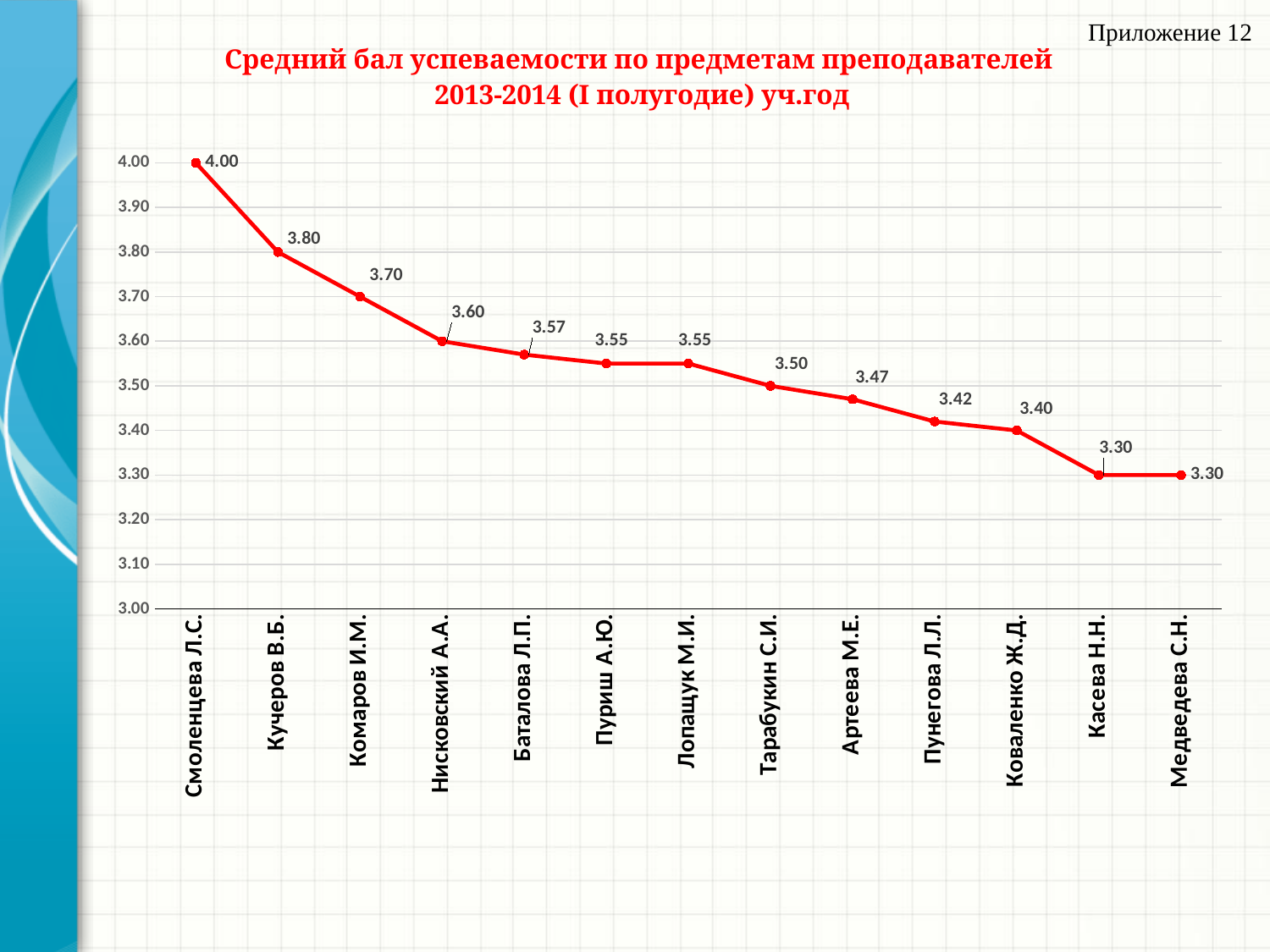
What is the lowest average score shown on the chart? 3.30 What is the difference between the scores of Тарабукин С.И. and Пунегова Л.Л.? 0.08 What kind of chart is shown on the slide? line chart What is the average score for Баталова Л.П.? 3.57 What is the average score for Артеева М.Е.? 3.47 What is the difference between the scores of Смоленцева Л.С. and Медведева С.Н.? 0.70 How many teachers are shown on the chart? 13 Which teacher has the highest average score? Смоленцева Л.С. What is the average score for Кучеров В.Б.? 3.80 Who has the higher average score, Комаров И.М. or Коваленко Ж.Д.? Комаров И.М. Is the value for Нисковский А.А. greater or less than 3.50? greater Do the values rise or fall from left to right along the x axis? fall